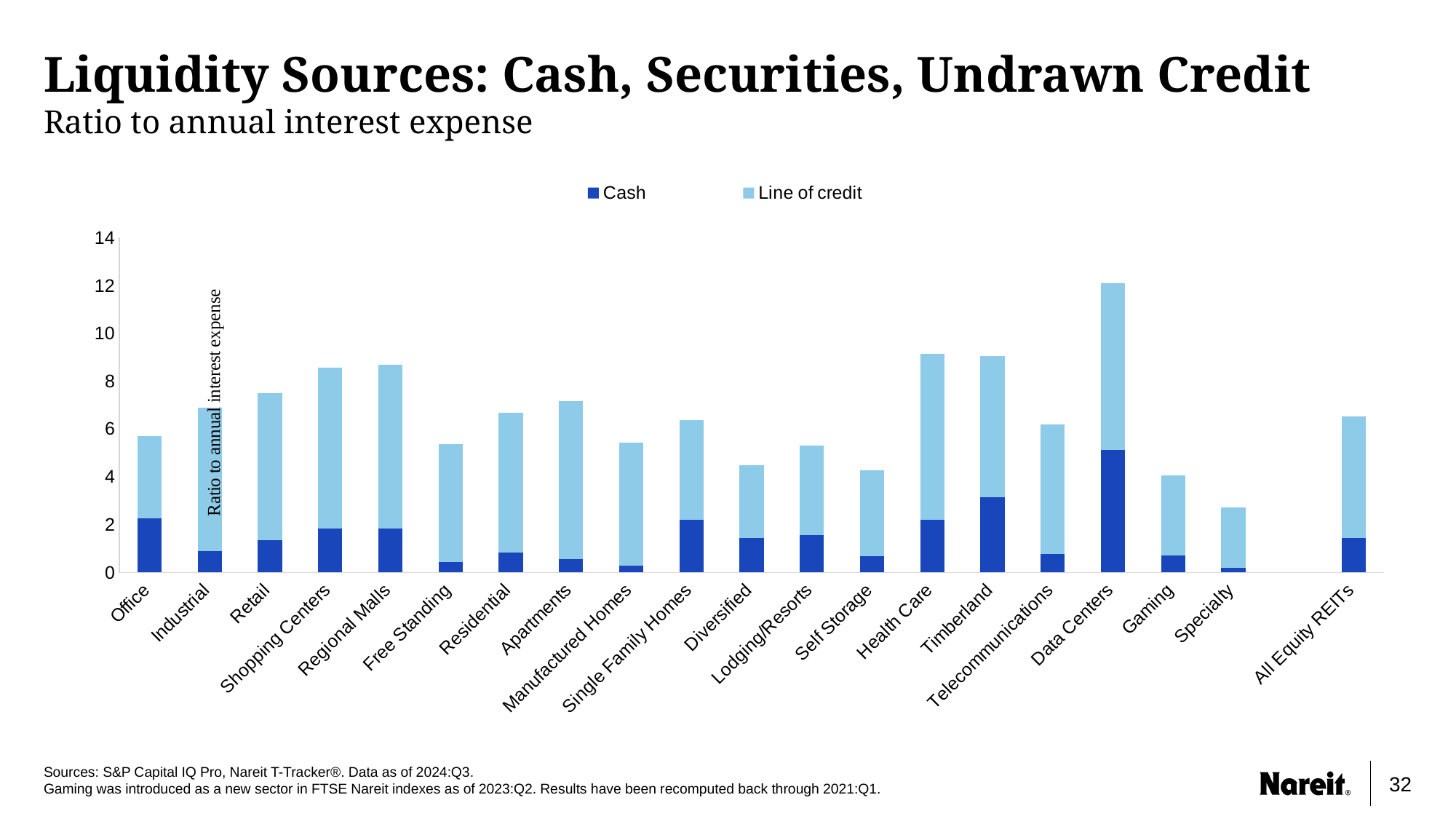
Which sector has the highest total ratio to annual interest expense? Data Centers How many sectors (categories) are shown along the x axis? 20 What kind of chart is shown on the slide? stacked bar chart Is the total value for Specialty greater or less than 4? less How many series does the legend list? 2 Is the Cash value for Timberland greater or less than 2? greater Which sector has the largest Cash component? Data Centers Is the total value for Data Centers greater or less than 10? greater Which sector has the lowest total ratio to annual interest expense? Specialty What are the two series named in the legend? Cash and Line of credit Which has the larger total ratio, Single Family Homes or Manufactured Homes? Single Family Homes